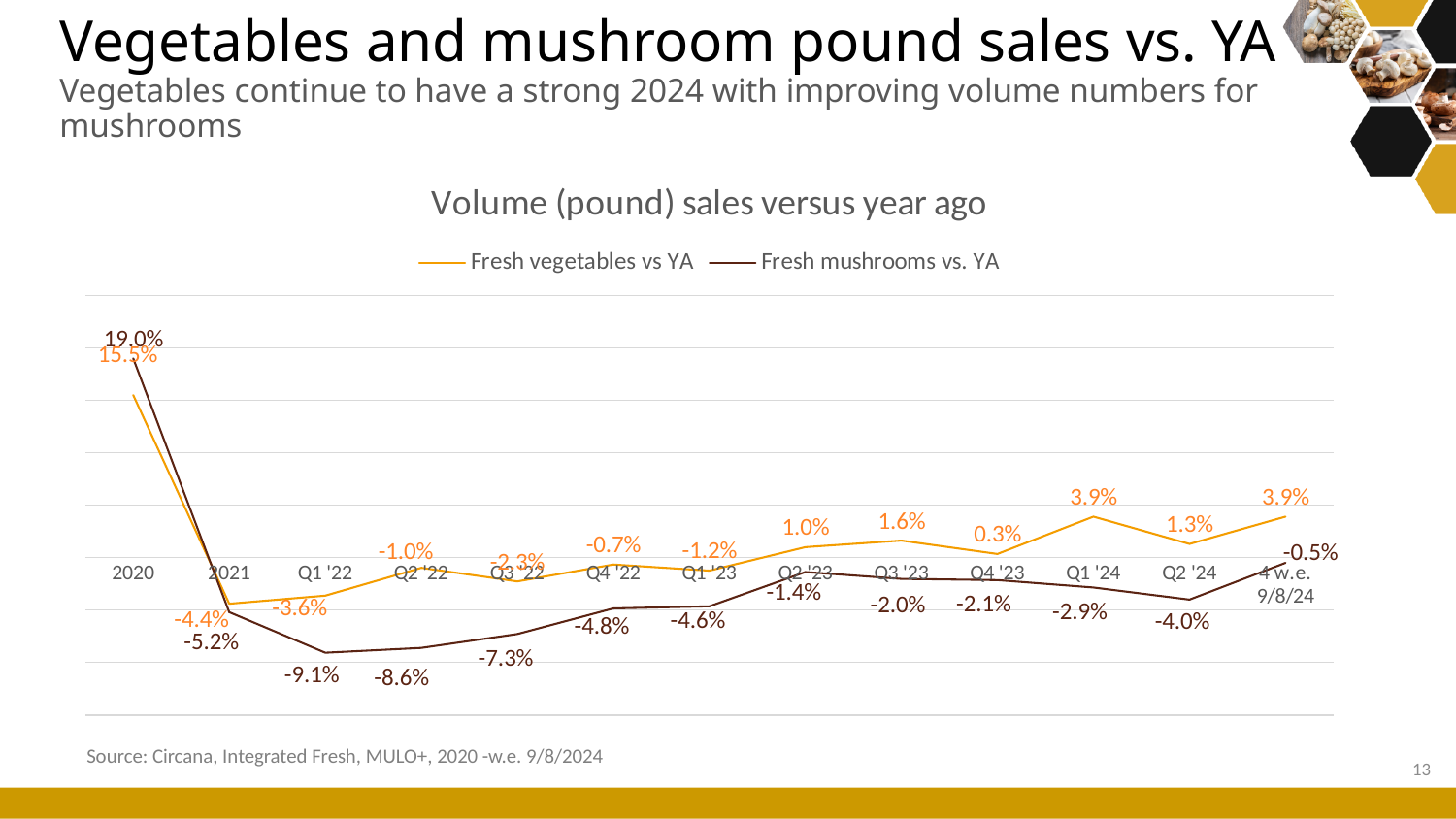
How many series does the legend list? 2 What is the value for Fresh mushrooms vs. YA for the 4 w.e. 9/8/24 period? -0.5% What is the difference between Fresh vegetables vs YA and Fresh mushrooms vs. YA in Q2 '24? 5.3 percentage points What is the value for Fresh vegetables vs YA in 2020? 15.5% What is the value for Fresh mushrooms vs. YA in Q1 '22? -9.1% What is the title of the chart? Volume (pound) sales versus year ago Which period has the lowest value for Fresh mushrooms vs. YA? Q1 '22 What is the value for Fresh vegetables vs YA in Q1 '24? 3.9% How many periods are plotted along the x axis? 13 Which series has the higher value in 2020, Fresh vegetables vs YA or Fresh mushrooms vs. YA? Fresh mushrooms vs. YA What kind of chart is shown on the slide? Line chart Which period has the highest value for Fresh vegetables vs YA? 2020